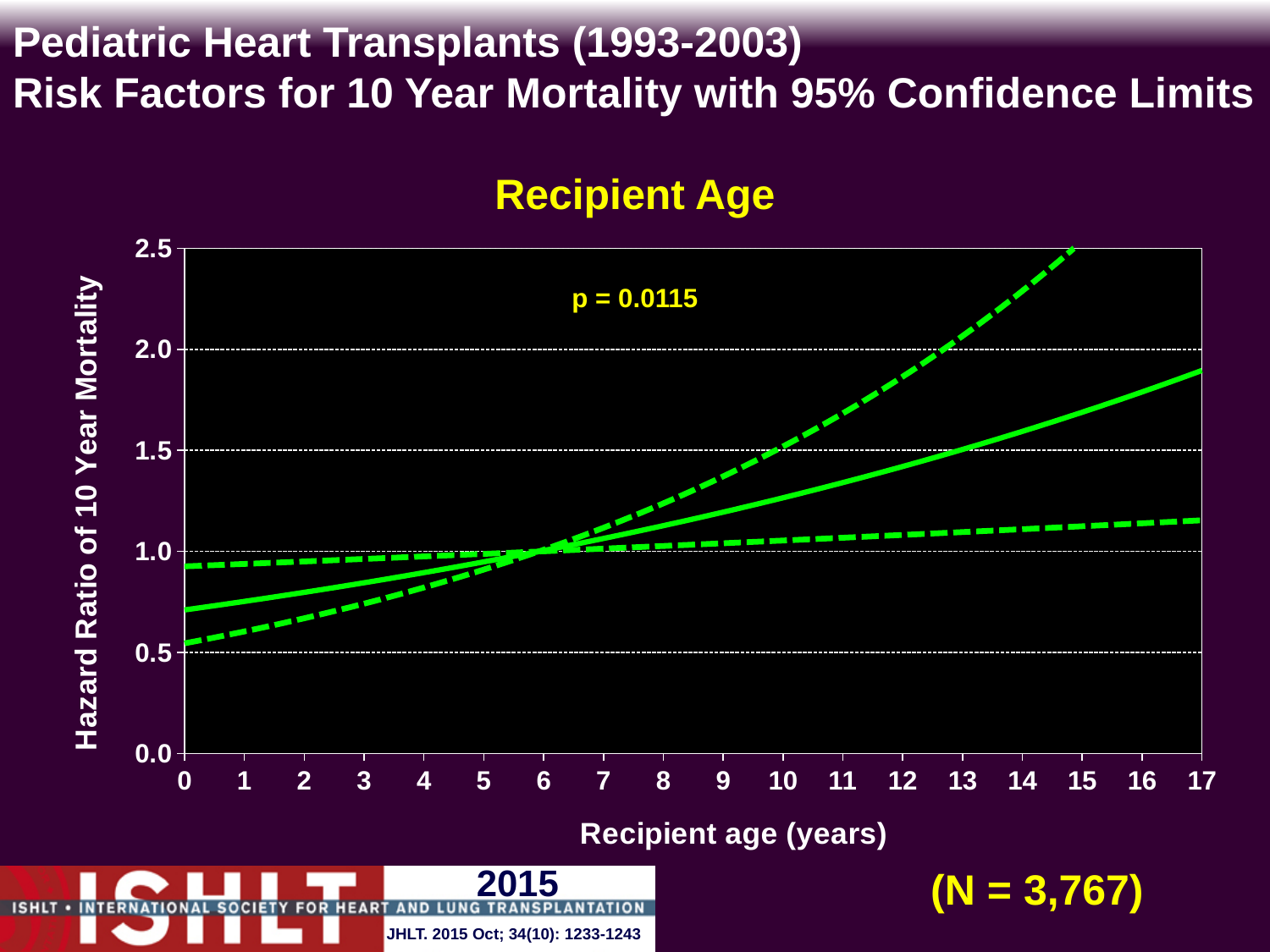
What is the highest value shown on the y axis? 2.5 Is the solid hazard ratio line at recipient age 17 greater or less than 1.5? greater Is the lower dashed confidence limit at recipient age 0 greater or less than 1.0? less What p value is printed on the chart? p = 0.0115 Is the solid hazard ratio line at recipient age 0 greater or less than 1.0? less How many lines are plotted on the chart? 3 What kind of chart is shown on the slide? line chart Does the solid hazard ratio line rise or fall as recipient age increases? rises